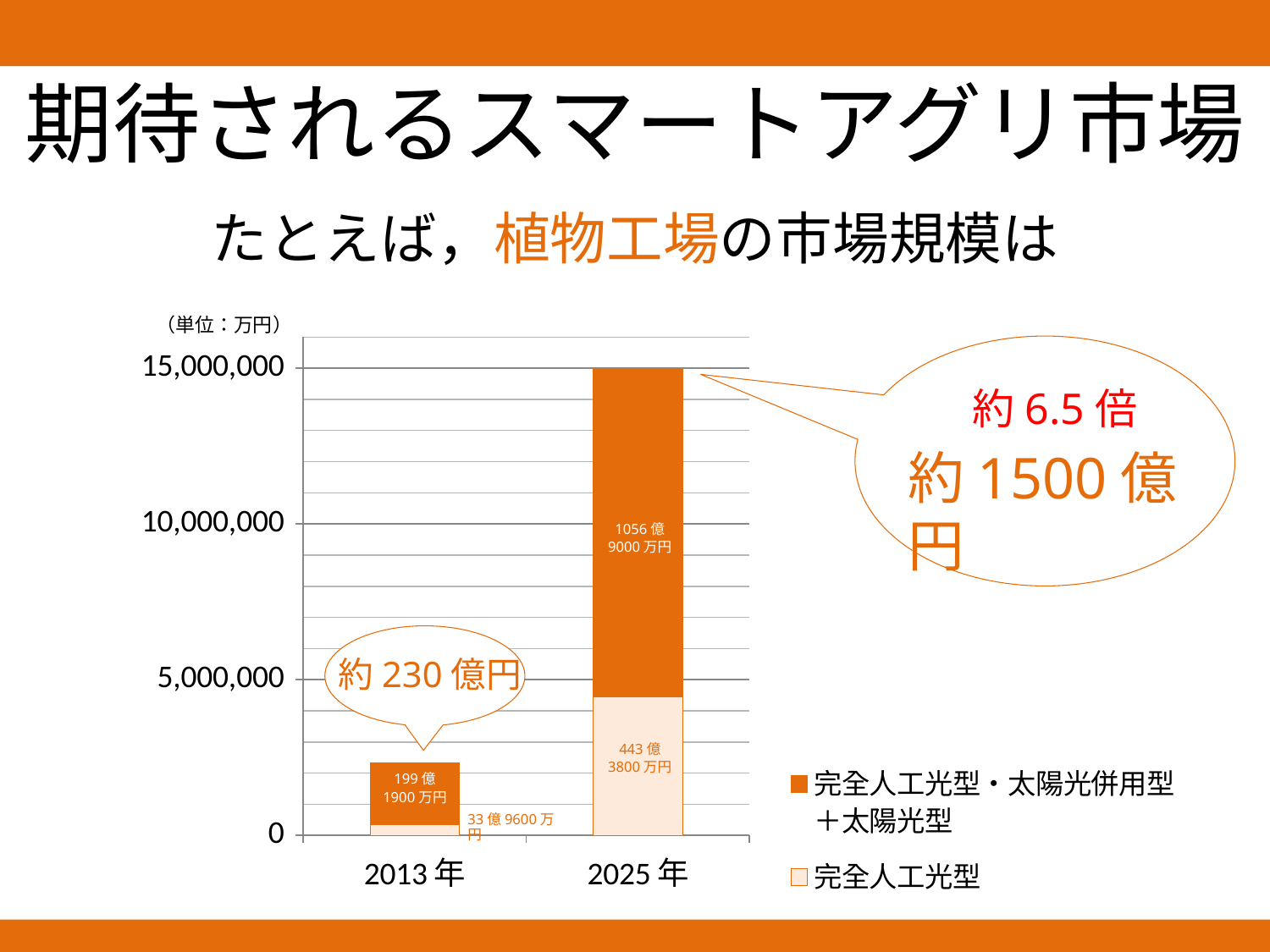
What is the value of the 完全人工光型 segment for 2025年? 443億3800万円 Is the total stacked bar for 2013年 greater or less than 5,000,000 on the axis? less How many years (categories) are shown on the x axis of the chart? 2 What kind of chart is shown on the slide? stacked bar chart What unit is stated for the chart's vertical axis? 万円 What is the value of the 完全人工光型・太陽光併用型＋太陽光型 segment for 2025年? 1056億9000万円 Is the total stacked bar for 2025年 greater or less than 10,000,000 on the axis? greater According to the callout on the chart, by roughly how many times does the market grow from 2013年 to 2025年? 約6.5倍 How many series does the chart legend list? 2 Which year has the taller stacked bar, 2013年 or 2025年? 2025年 What is the value of the 完全人工光型 segment for 2013年? 33億9600万円 What is the value of the 完全人工光型・太陽光併用型＋太陽光型 segment for 2013年? 199億1900万円